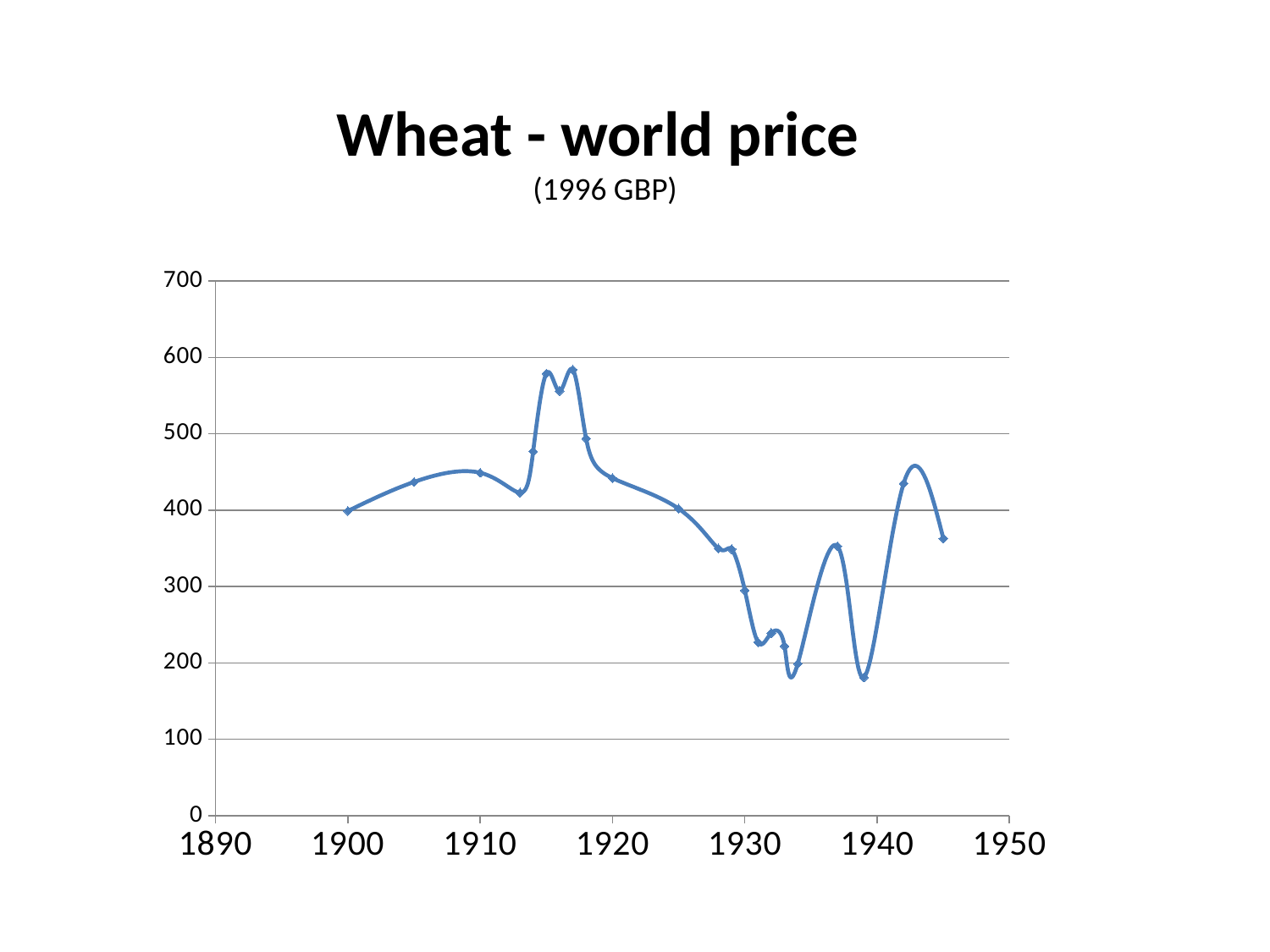
Is the value for 1939 greater or less than 200? less Does the wheat price rise or fall between 1920 and 1931? fall Which year has the higher wheat price, 1917 or 1945? 1917 Which year has the higher wheat price, 1920 or 1933? 1920 What kind of chart is shown on the slide? line chart Is the value for 1905 greater or less than 400? greater Is the value for 1917 greater or less than 500? greater In what units are the wheat prices expressed, according to the subtitle? 1996 GBP What is the title of the chart? Wheat - world price